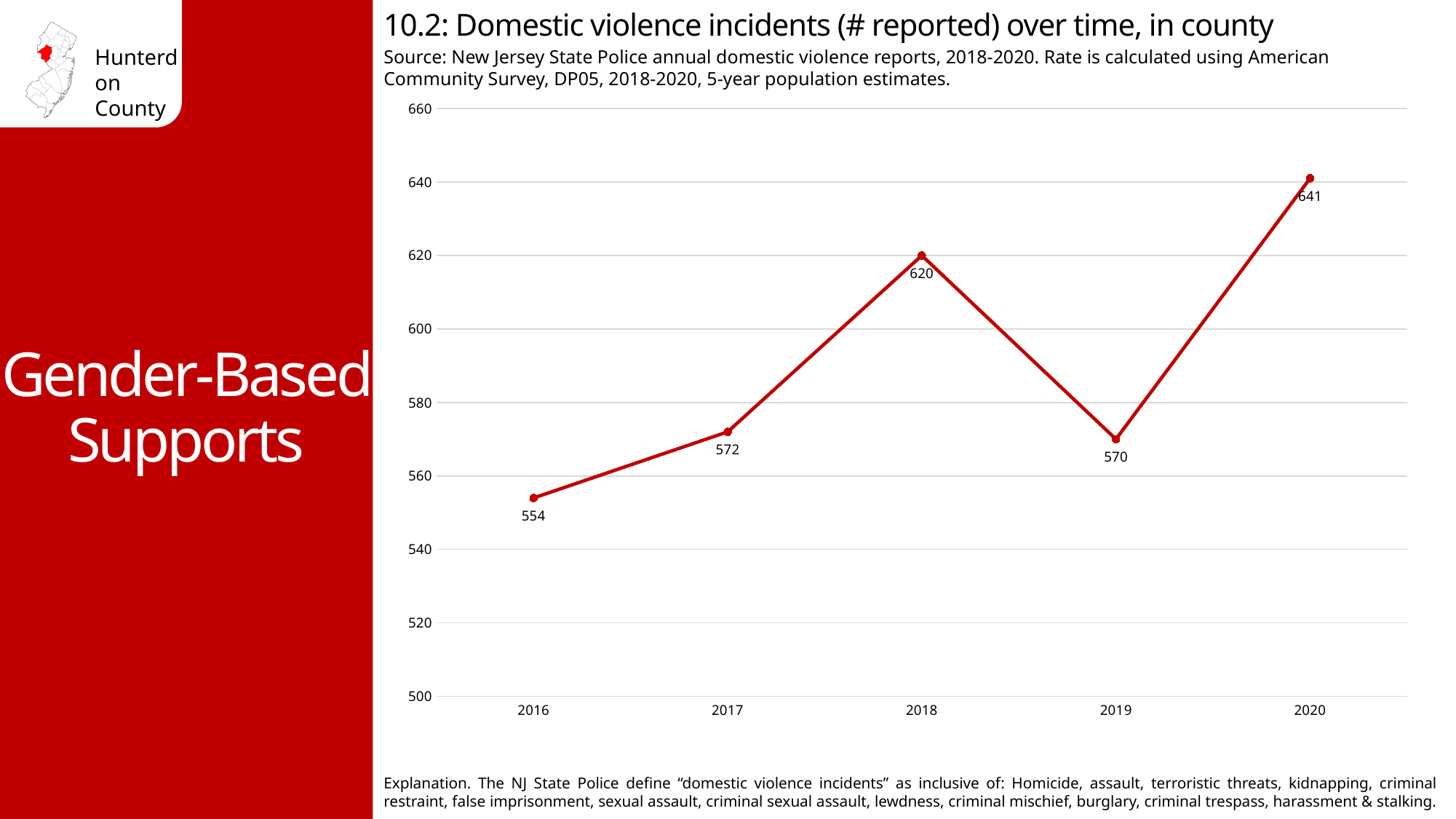
What type of chart is shown on the slide? line chart Is the value for 2019 greater or less than 580? less Which year had the lowest number of reported domestic violence incidents? 2016 How many years are plotted on the chart? 5 Which year had the highest number of reported domestic violence incidents? 2020 What is the difference in reported incidents between 2020 and 2019? 71 Did the number of reported incidents rise or fall from 2018 to 2019? fall Which year had more reported incidents, 2017 or 2019? 2017 By how much did reported incidents increase from 2016 to 2017? 18 What is the title of the chart? 10.2: Domestic violence incidents (# reported) over time, in county How many domestic violence incidents were reported in 2018? 620 What was the number of reported domestic violence incidents in 2016? 554